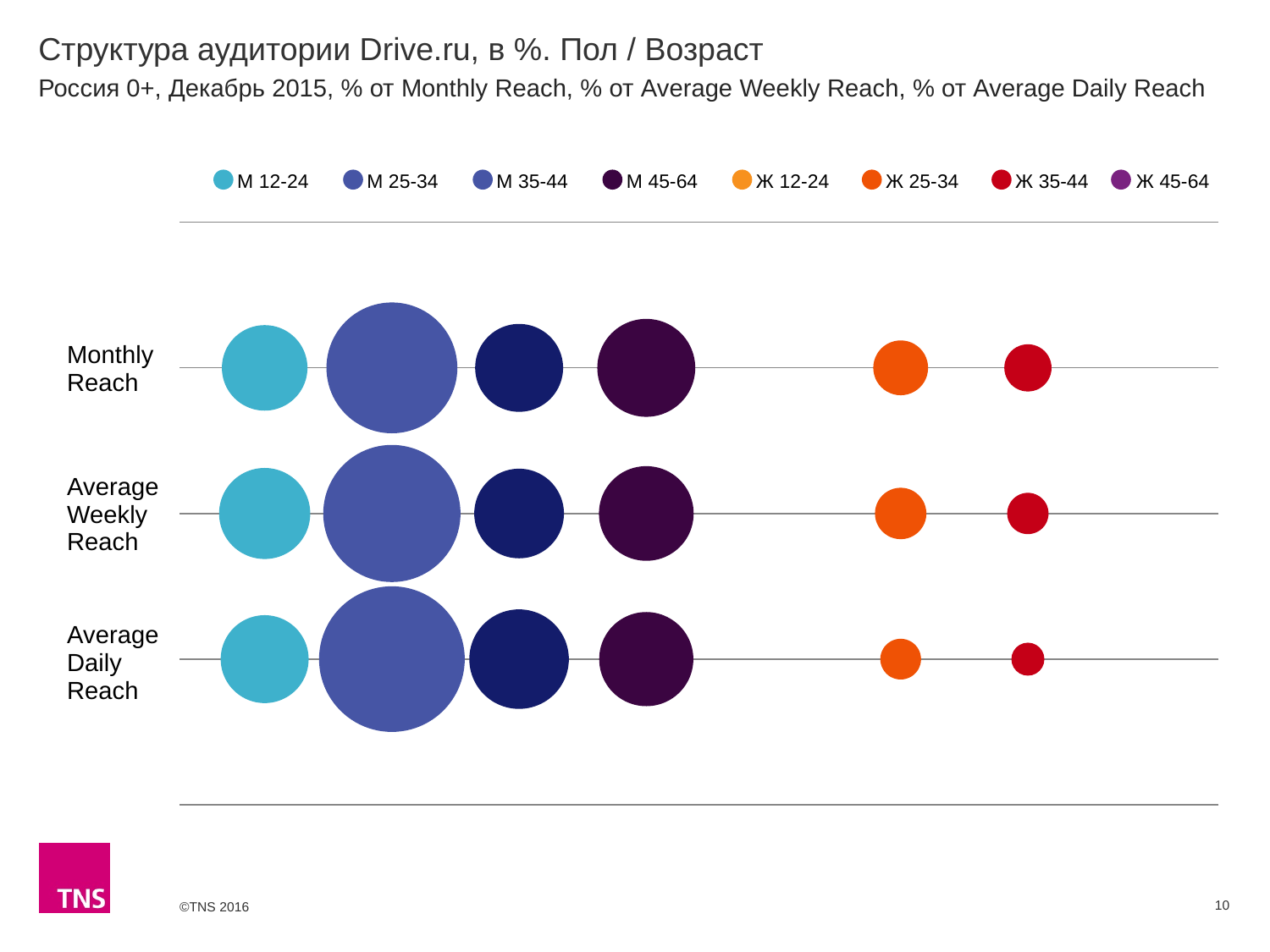
How many series does the legend list? 8 In the Average Daily Reach row, which is larger: the bubble for М 25-34 or the bubble for Ж 35-44? М 25-34 What is the title of the slide? Структура аудитории Drive.ru, в %. Пол / Возраст How many reach categories (rows) are plotted on the chart? 3 Which two legend series have no visible bubble in any row of the chart? Ж 12-24 and Ж 45-64 Which series has the largest bubble in the Average Weekly Reach row? М 25-34 What are the labels of the three rows on the chart, from top to bottom? Monthly Reach, Average Weekly Reach, Average Daily Reach Among the bubbles visible in the Average Daily Reach row, which series has the smallest bubble? Ж 35-44 Which series has the largest bubble in the Monthly Reach row? М 25-34 In the Monthly Reach row, which is larger: the bubble for М 12-24 or the bubble for Ж 25-34? М 12-24 What kind of chart is shown on the slide? bubble chart Which series has the largest bubble in the Average Daily Reach row? М 25-34